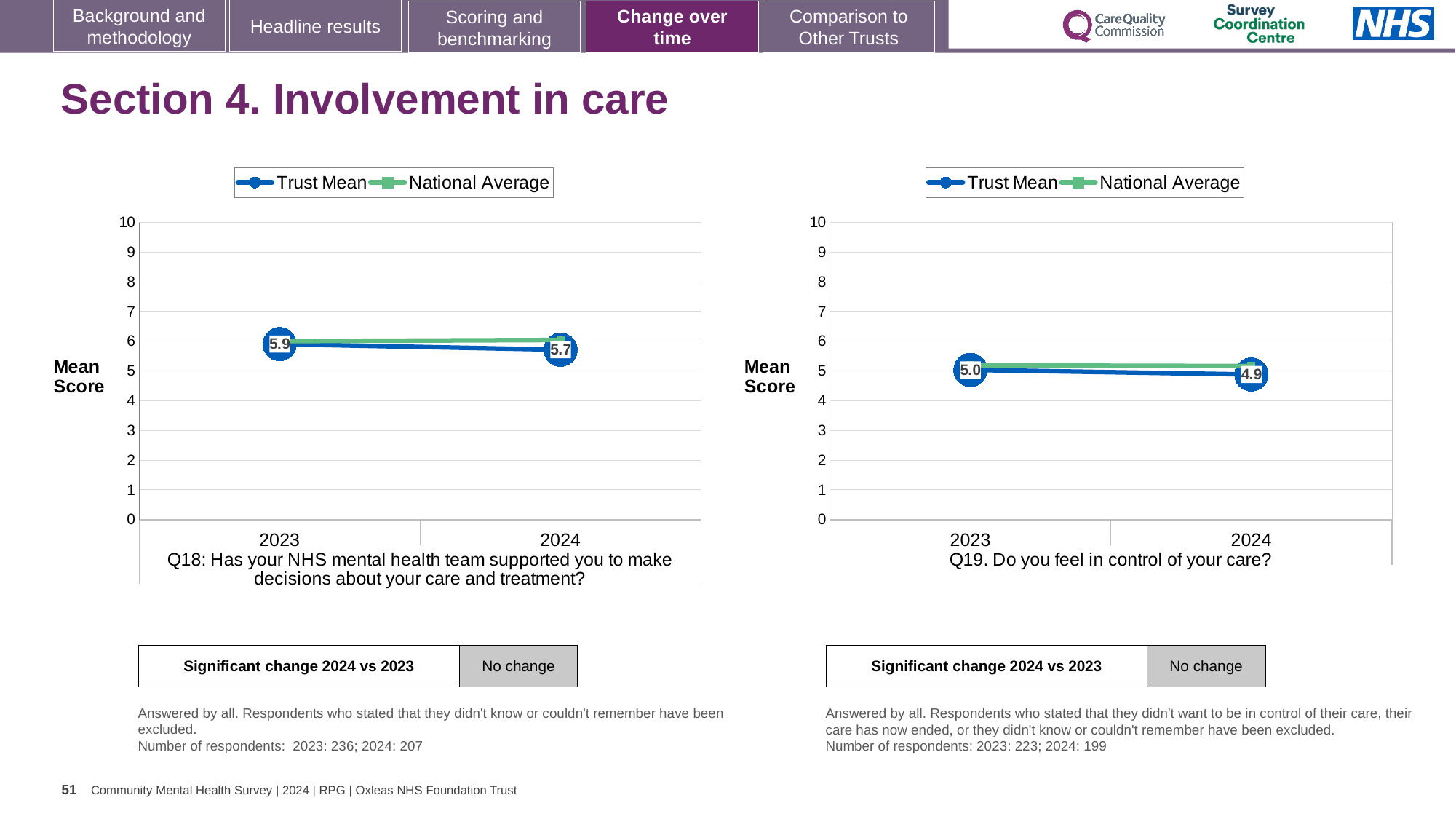
In the right chart (Q19), what is the difference between the Trust Mean in 2023 and 2024? 0.1 What kind of chart is the right chart (Q19)? line chart In the right chart (Q19), what is the Trust Mean score for 2024? 4.9 What is the label of the y axis on the left chart (Q18)? Mean Score In the left chart (Q18), does the Trust Mean rise or fall from 2023 to 2024? fall In the left chart (Q18), what is the Trust Mean score for 2024? 5.7 In the left chart (Q18), by how much did the Trust Mean change from 2023 to 2024? 0.2 In the left chart (Q18), is the Trust Mean for 2024 greater or less than 6? less How many years are plotted on the x axis of the right chart (Q19)? 2 In the right chart (Q19), what is the Trust Mean score for 2023? 5.0 How many series does the legend of the left chart (Q18) list? 2 In the left chart (Q18), what is the Trust Mean score for 2023? 5.9